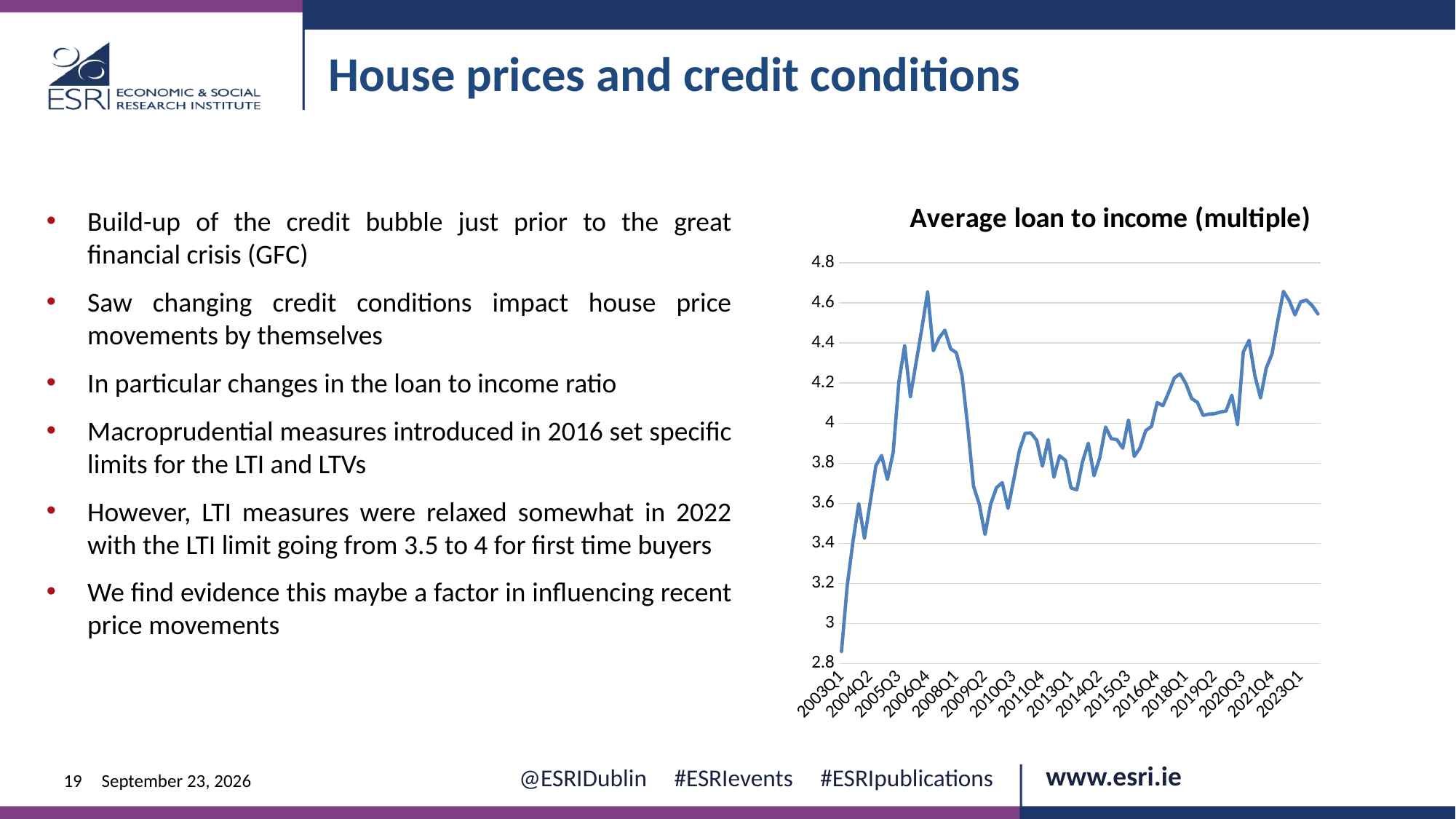
Is the value for 2023Q1 greater or less than 4.4? greater Does the line rise or fall between 2006Q4 and 2009Q2? fall Is the value for 2009Q2 greater or less than 3.6? less Which is larger, the value for 2003Q1 or the value for 2023Q1? 2023Q1 What kind of chart is shown on the slide? line chart Is the value for 2013Q1 greater or less than 4? less What is the title of the chart? Average loan to income (multiple) Overall, does the line rise or fall from 2003Q1 to 2023Q1? rise Which is larger, the value for 2006Q4 or the value for 2009Q2? 2006Q4 How many tick labels are shown on the x axis? 17